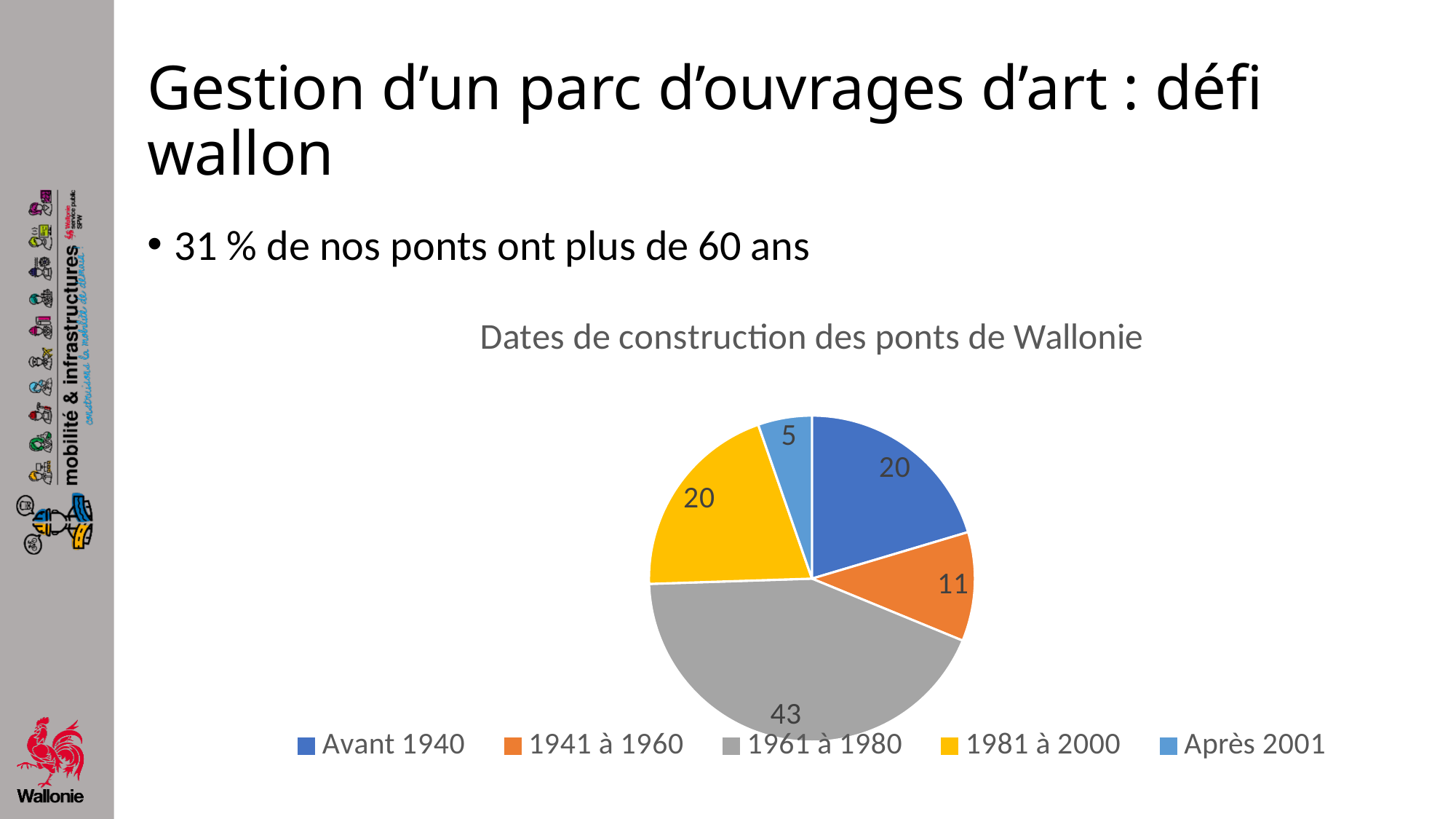
What is the title of the chart? Dates de construction des ponts de Wallonie What is the difference between the values for '1961 à 1980' and '1941 à 1960'? 32 Which category has the largest slice of the pie? 1961 à 1980 What is the value for the '1961 à 1980' slice? 43 Which category has the smallest slice of the pie? Après 2001 Which colour is used for the '1981 à 2000' slice? yellow How many categories does the pie chart have? 5 Which is larger, the value for '1941 à 1960' or the value for 'Après 2001'? 1941 à 1960 What kind of chart is shown on the slide? pie chart What is the value for the '1941 à 1960' slice? 11 What is the value for the 'Après 2001' slice? 5 What is the value for the 'Avant 1940' slice? 20